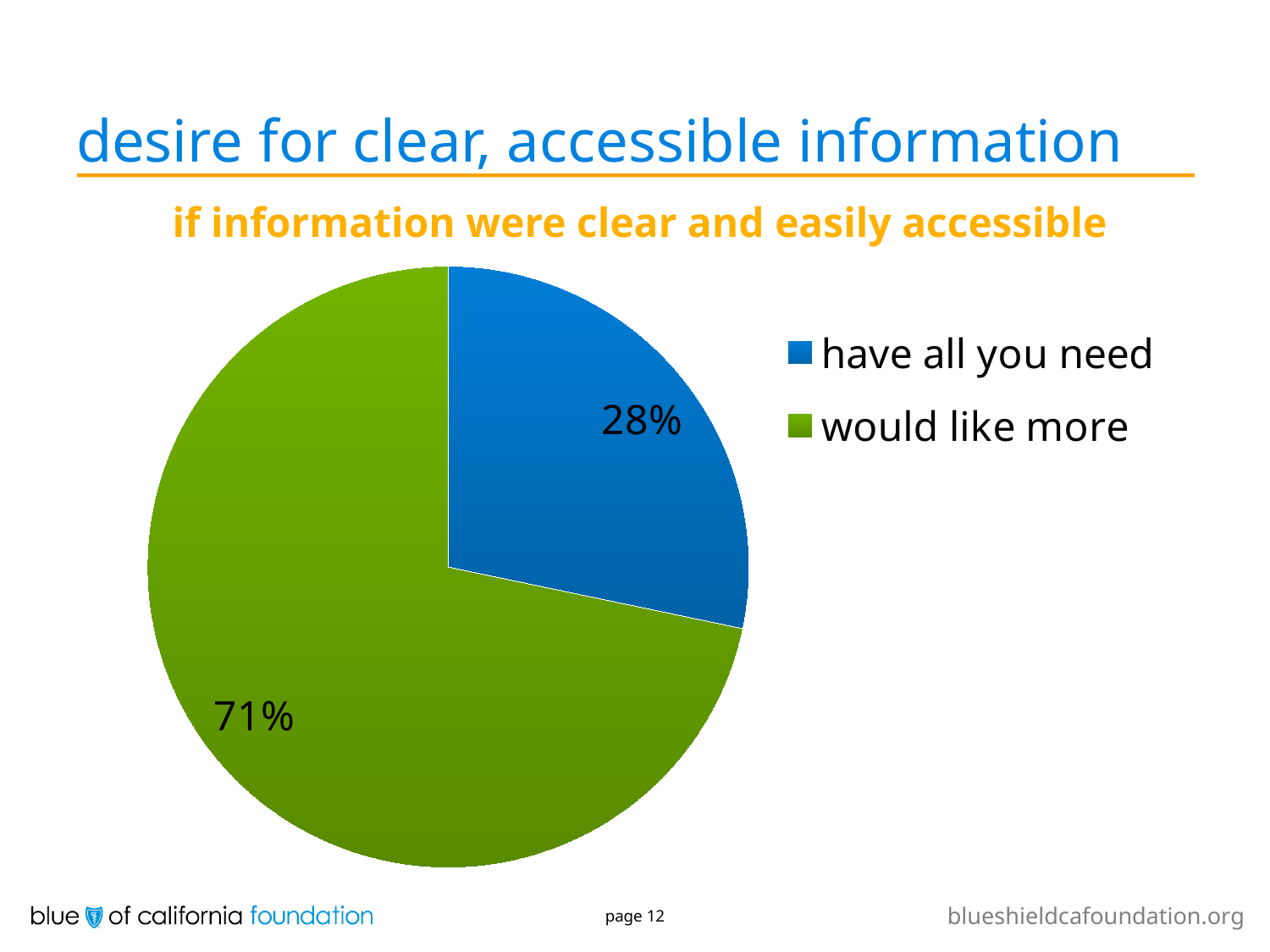
What share of the pie does the "would like more" slice represent? 71% Which slice of the pie is the largest? would like more What is the title shown above the pie chart? if information were clear and easily accessible What percentage of the pie is labelled "have all you need"? 28% How many entries does the legend list? 2 What kind of chart is shown on the slide? pie chart Which is larger: the "have all you need" slice or the "would like more" slice? would like more What percentage of the pie is labelled "would like more"? 71% What colour is the "have all you need" slice? blue How many slices does the pie chart have? 2 What is the difference in percentage points between the "would like more" slice and the "have all you need" slice? 43 Which slice of the pie is the smallest? have all you need